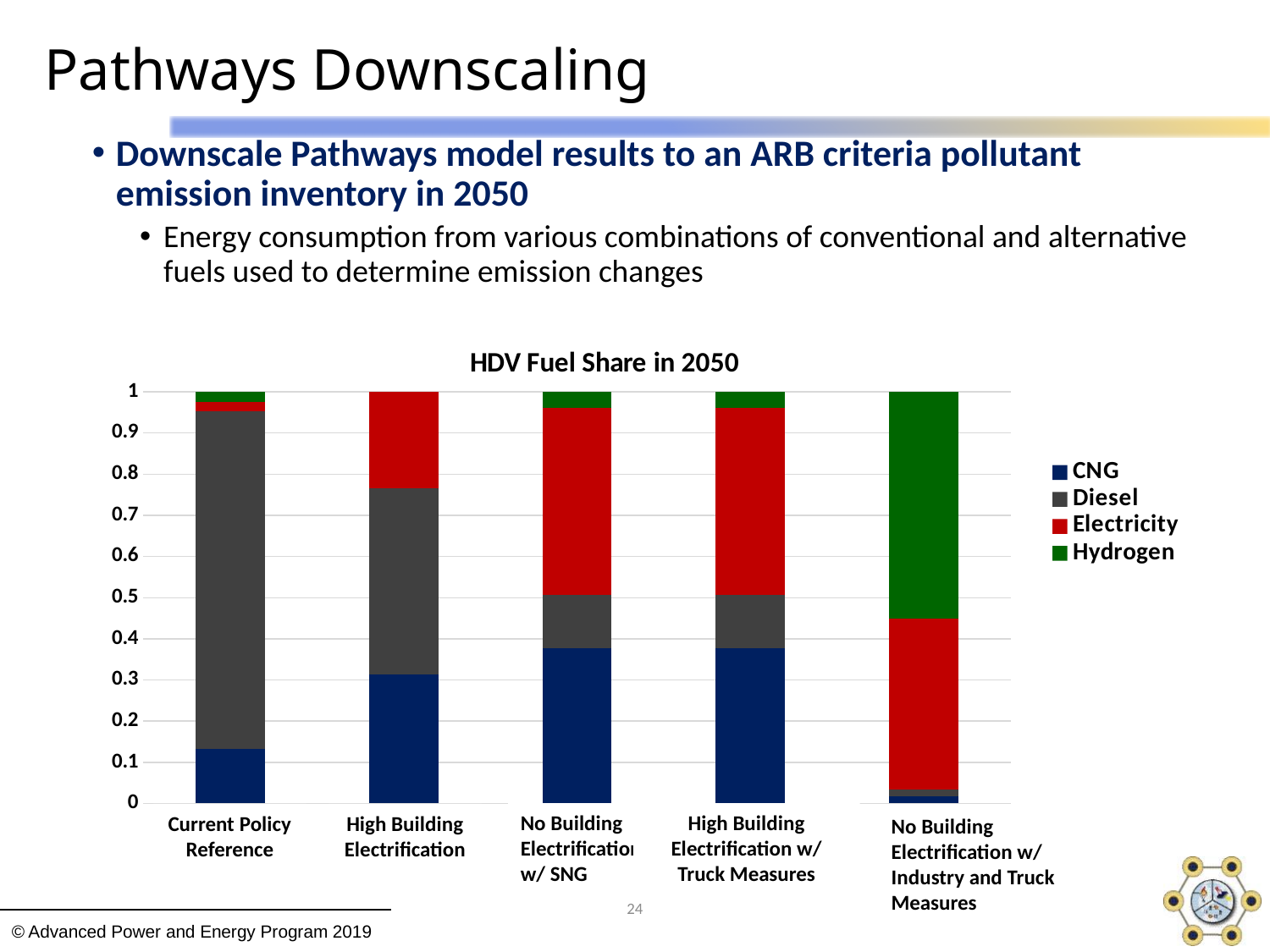
Which scenario has the smallest Diesel share? No Building Electrification w/ Industry and Truck Measures Which fuel is shown in green in the chart? Hydrogen Is the CNG share for Current Policy Reference greater or less than 0.2? less What is the title of the chart? HDV Fuel Share in 2050 Which scenario has the largest Hydrogen share? No Building Electrification w/ Industry and Truck Measures How many series does the chart legend list? 4 Which scenario has the largest Diesel share? Current Policy Reference Which scenario has the larger CNG share, Current Policy Reference or High Building Electrification? High Building Electrification What kind of chart is shown on the slide? stacked bar chart Is the Electricity share for No Building Electrification w/ SNG greater or less than 0.4? greater How many scenario categories are shown on the x axis of the chart? 5